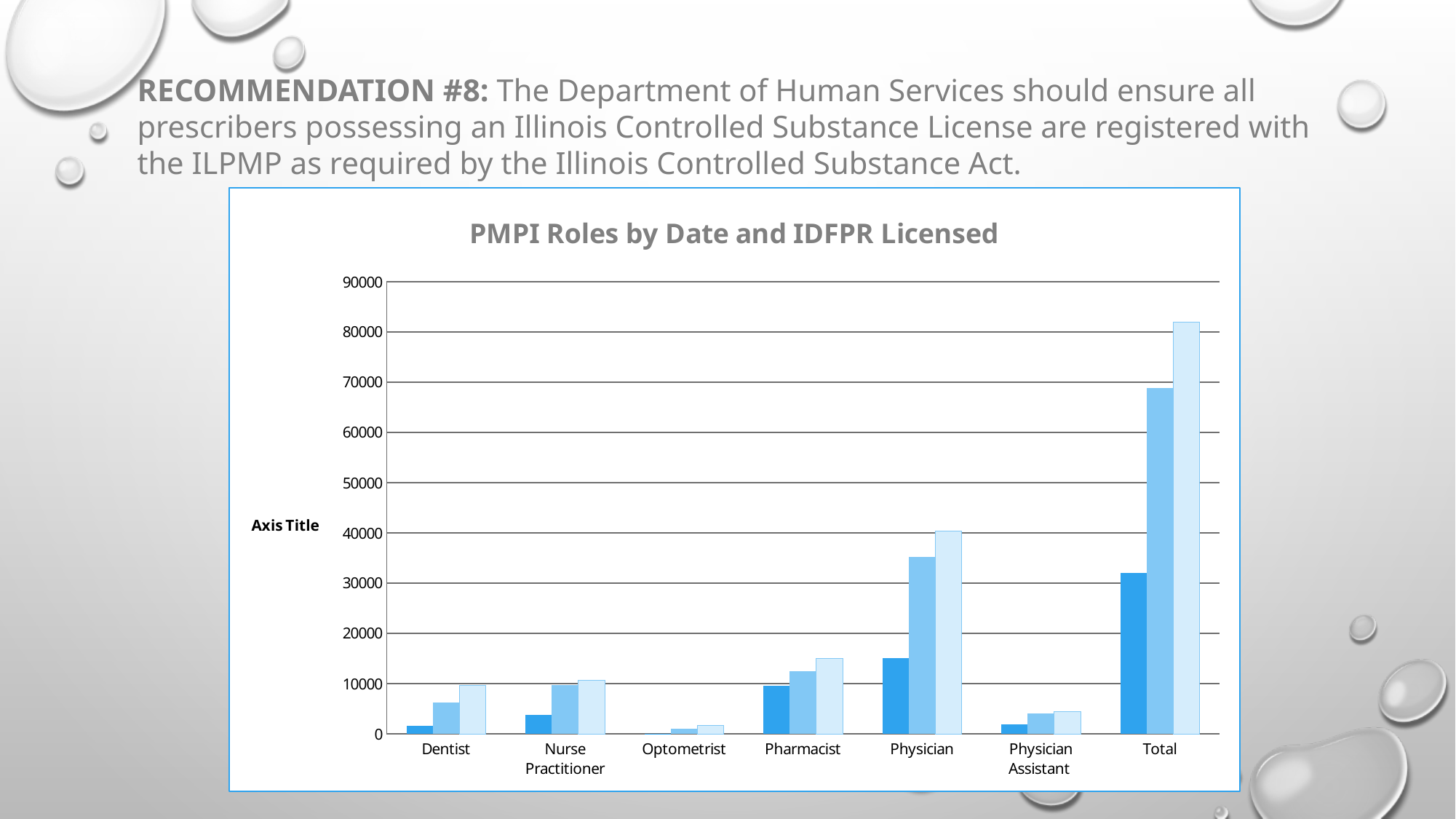
What is the title of the chart? PMPI Roles by Date and IDFPR Licensed Is the value of the darkest blue bar for Physician greater or less than 20000? less Which category has the tallest bars in the chart? Total How many categories are shown on the x axis of the chart? 7 Within each category, do the three bars rise or fall from left to right? rise Is the value of the middle (medium blue) bar for Physician greater or less than 30000? greater Which category has a taller lightest blue bar, Physician or Pharmacist? Physician Is the value of the lightest blue bar for Total greater or less than 80000? greater What kind of chart is shown on the slide? bar chart Excluding the Total category, which category has the tallest bars? Physician Which category has the shortest bars in the chart? Optometrist How many bars are plotted for each category in the chart? 3